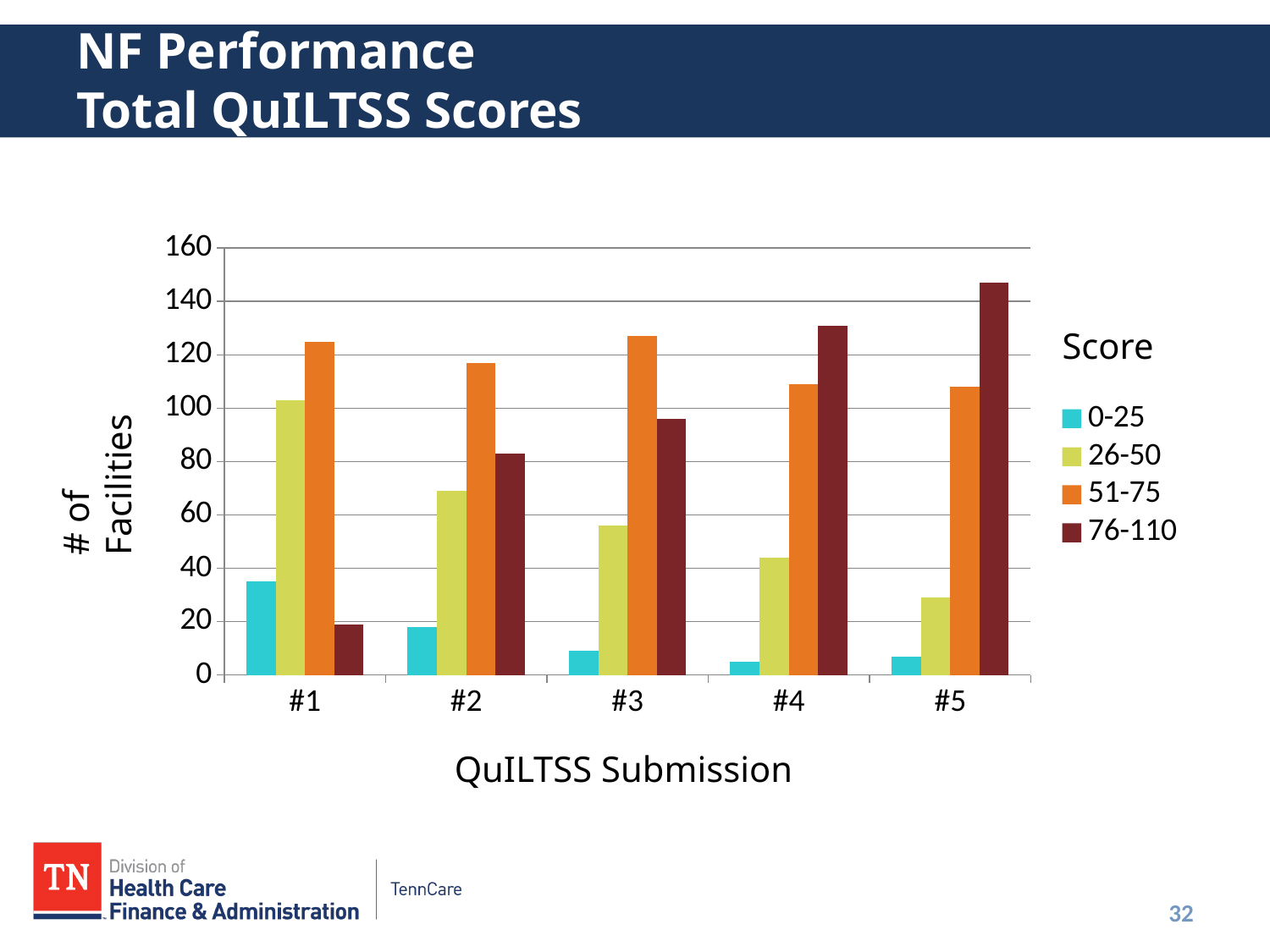
Which submission has the highest number of facilities scoring 76-110? #5 Does the number of facilities scoring 26-50 rise or fall from submission #1 to submission #5? fall Is the number of facilities scoring 76-110 at submission #5 greater or less than 140? greater Is the number of facilities scoring 0-25 at submission #1 greater or less than 40? less Is the number of facilities scoring 51-75 at submission #1 greater or less than 120? greater Which submission has the lowest number of facilities scoring 26-50? #5 At submission #2, which is larger: the number of facilities scoring 51-75 or the number scoring 76-110? 51-75 How many series does the legend list? 4 Does the number of facilities scoring 76-110 rise or fall from submission #1 to submission #5? rise What is the title of the legend? Score What kind of chart is shown on the slide? bar chart How many QuILTSS submissions are shown on the x axis? 5